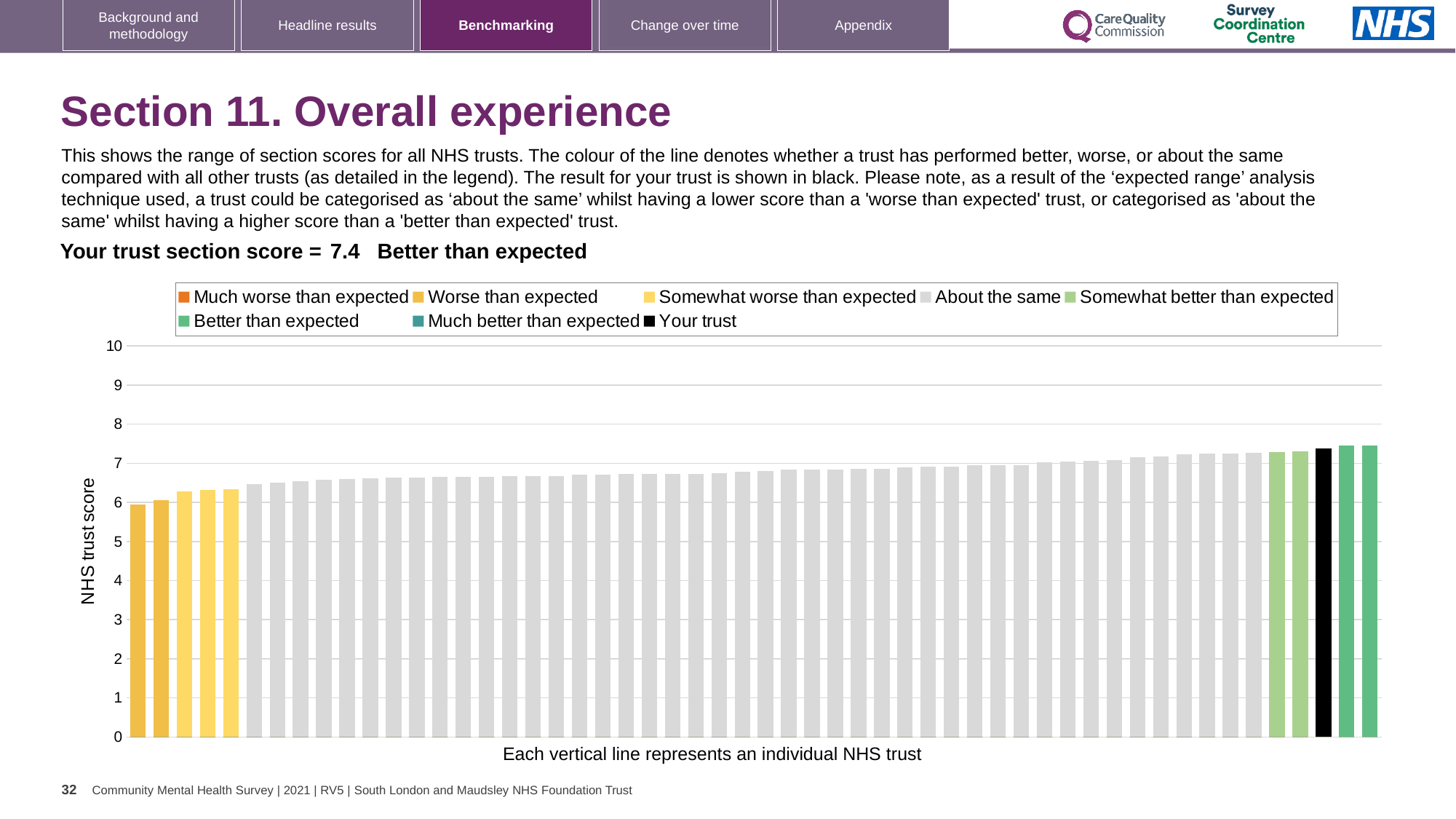
What is the section score for your trust shown on the slide? 7.4 Is the value of the tallest bar in the chart greater or less than 8? less Is the value for your trust (the black bar) greater or less than 7? greater What kind of chart is shown on the slide? bar chart Which is larger: the value for your trust (black bar) or the value of the leftmost bar? your trust What colour is the bar representing your trust? black Do the bar values rise or fall from left to right across the chart? rise Which performance category is your trust placed in for this section? Better than expected Is the value of the leftmost bar in the chart greater or less than 7? less How many entries does the chart legend list? 8 What is the label on the vertical axis of the chart? NHS trust score